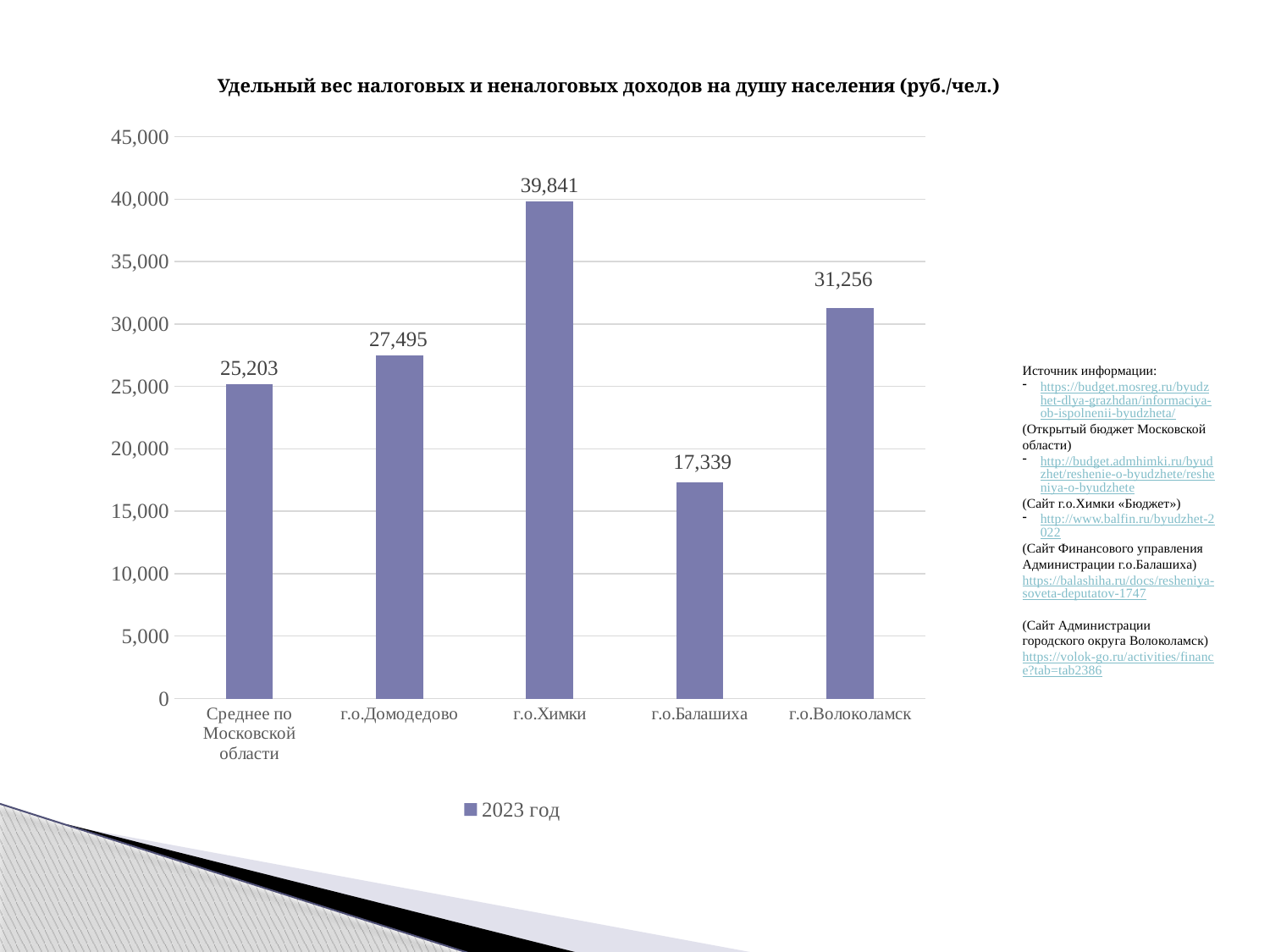
How many categories are shown on the x axis? 5 What is the value for г.о.Балашиха? 17,339 How many series does the legend list? 1 Is the value for г.о.Домодедово greater or less than 30,000? less Which is larger, the value for г.о.Домодедово or the value for г.о.Волоколамск? г.о.Волоколамск Which category has the lowest value? г.о.Балашиха What is the value for Среднее по Московской области? 25,203 What kind of chart is shown on the slide? bar chart What is the value for г.о.Химки? 39,841 Which category has the highest value? г.о.Химки What is the difference between the values for г.о.Химки and г.о.Балашиха? 22,502 What is the difference between the values for г.о.Волоколамск and г.о.Домодедово? 3,761